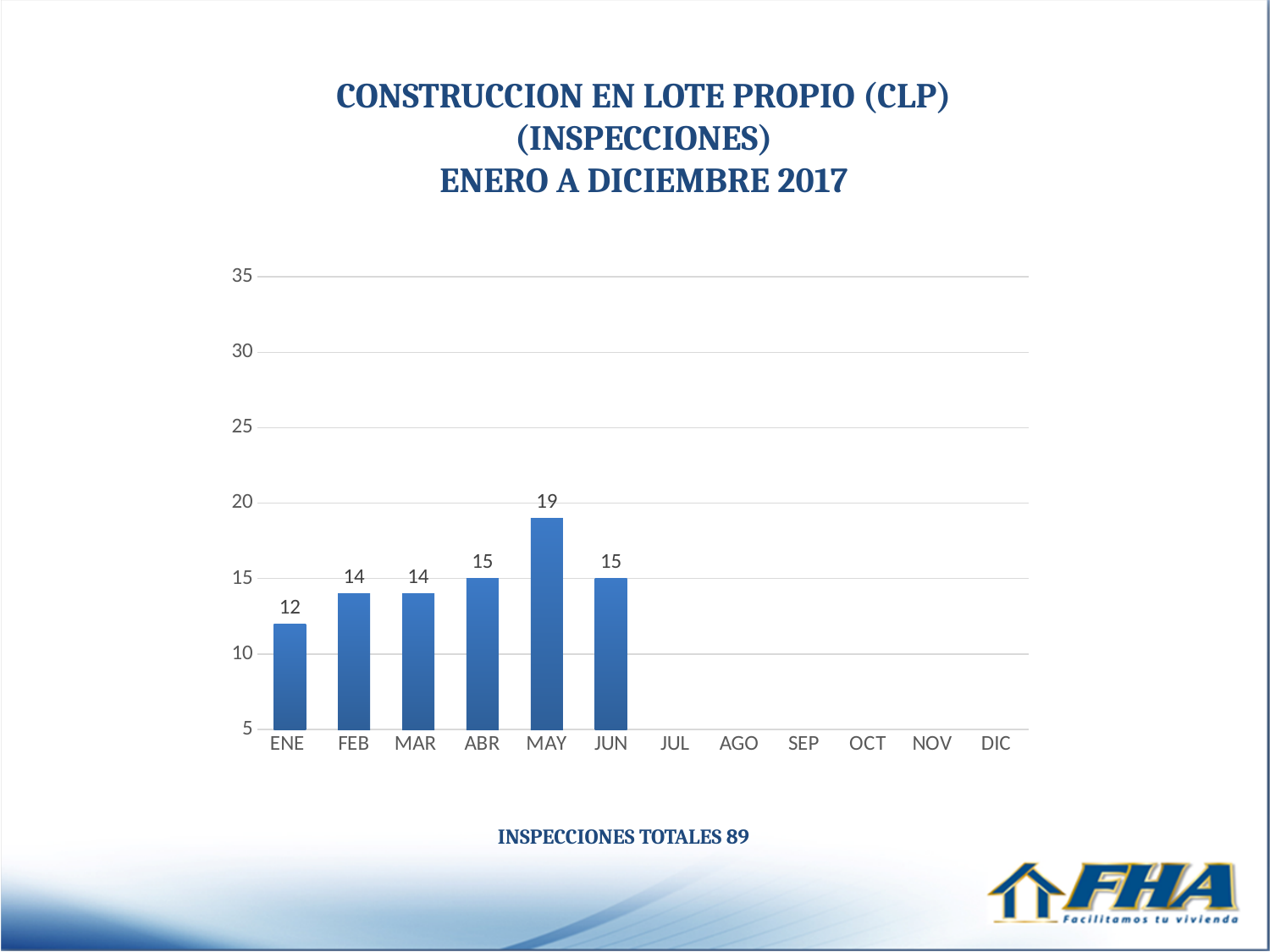
What total number of inspections is stated below the chart? 89 How many months have a bar plotted? 6 What is the value for MAY? 19 What is the value for ENE? 12 Which is larger, the value for FEB or the value for JUN? JUN Is the value for MAY greater or less than 15? greater What is the value for ABR? 15 How many months are labelled on the x axis? 12 What is the difference between the values for MAY and ENE? 7 What kind of chart is shown? bar chart Which month has the highest value? MAY Which month among those with bars has the lowest value? ENE